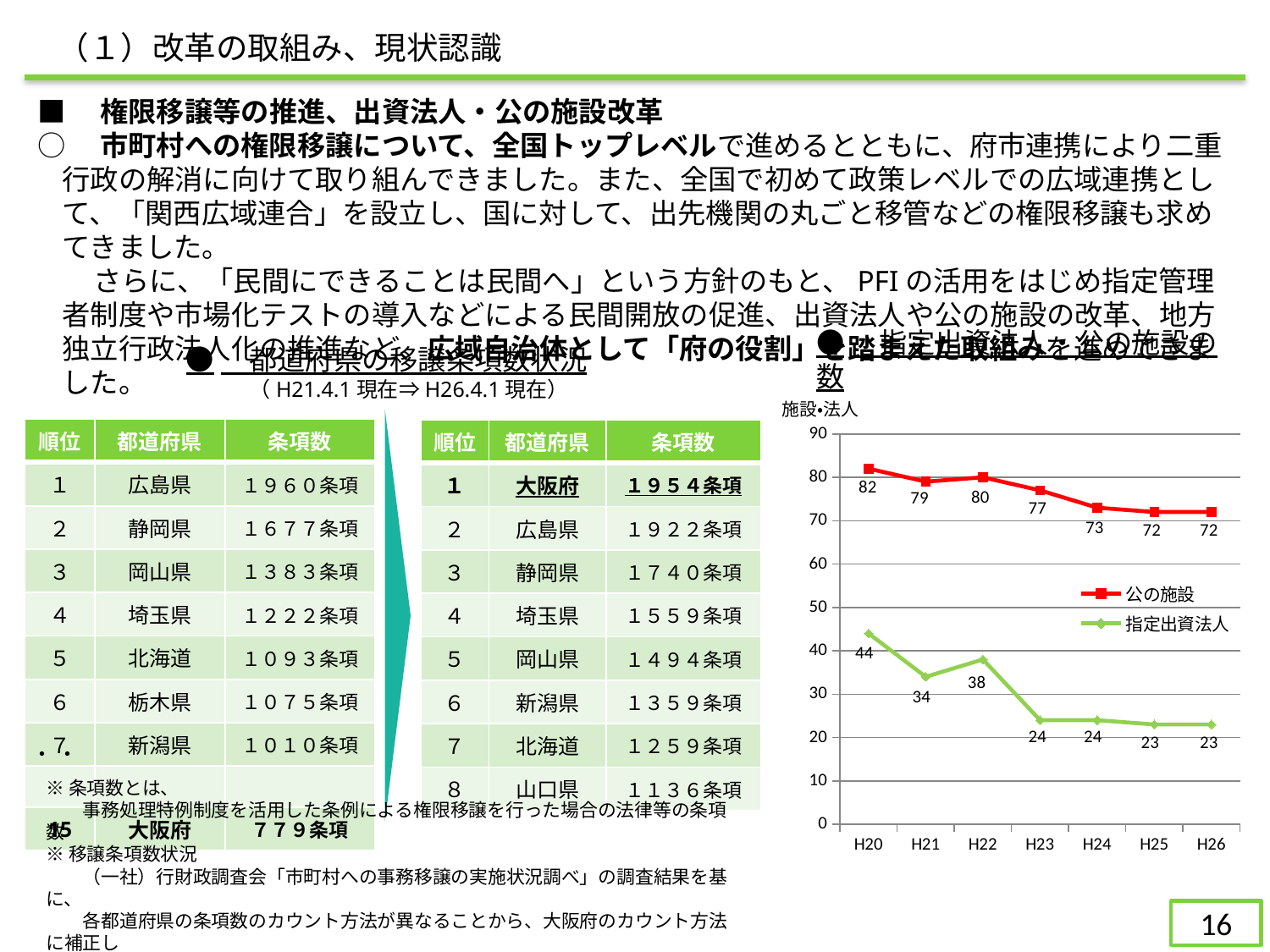
How many series does the chart's legend list? 2 What is the value of 指定出資法人 in H26? 23 What is the value of 公の施設 in H20? 82 Which is larger in H23: 公の施設 or 指定出資法人? 公の施設 In which year is 公の施設 lowest (first occurrence)? H25 What is the value of 指定出資法人 in H22? 38 In which year is 指定出資法人 highest? H20 What type of chart is shown on the slide? line chart Does the 指定出資法人 series generally rise or fall from H20 to H26? fall What is the value of 公の施設 in H24? 73 What is the difference between 公の施設 and 指定出資法人 in H20? 38 How many years are plotted on the x axis? 7